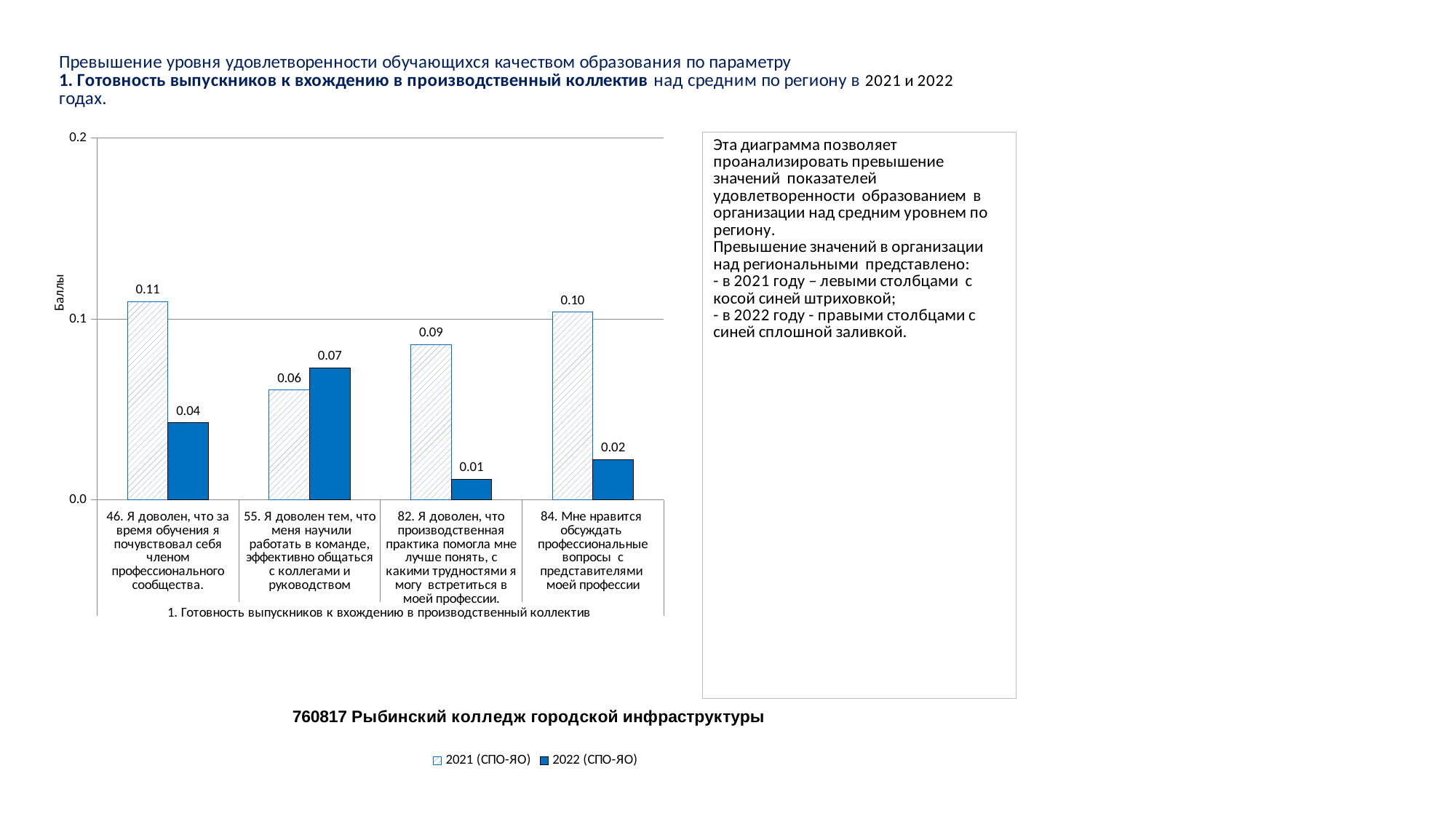
For category 55, which series has the larger value: 2021 (СПО-ЯО) or 2022 (СПО-ЯО)? 2022 (СПО-ЯО) Which category has the highest value for the 2021 (СПО-ЯО) series? 46. Я доволен, что за время обучения я почувствовал себя членом профессионального сообщества. What is the difference between the 2021 (СПО-ЯО) and 2022 (СПО-ЯО) values for category 84 (Мне нравится обсуждать профессиональные вопросы с представителями моей профессии)? 0.08 How many categories are shown on the x axis of the chart? 4 How many series does the legend list? 2 What is the value for 2022 (СПО-ЯО) for category 82 (Я доволен, что производственная практика помогла мне лучше понять, с какими трудностями я могу встретиться в моей профессии)? 0.01 What is the value for 2022 (СПО-ЯО) for category 55 (Я доволен тем, что меня научили работать в команде, эффективно общаться с коллегами и руководством)? 0.07 Which category has the lowest value for the 2022 (СПО-ЯО) series? 82. Я доволен, что производственная практика помогла мне лучше понять, с какими трудностями я могу встретиться в моей профессии. What is the label of the vertical axis of the chart? Баллы What is the value for 2021 (СПО-ЯО) for category 46 (Я доволен, что за время обучения я почувствовал себя членом профессионального сообщества)? 0.11 What kind of chart is shown on the slide? Bar chart